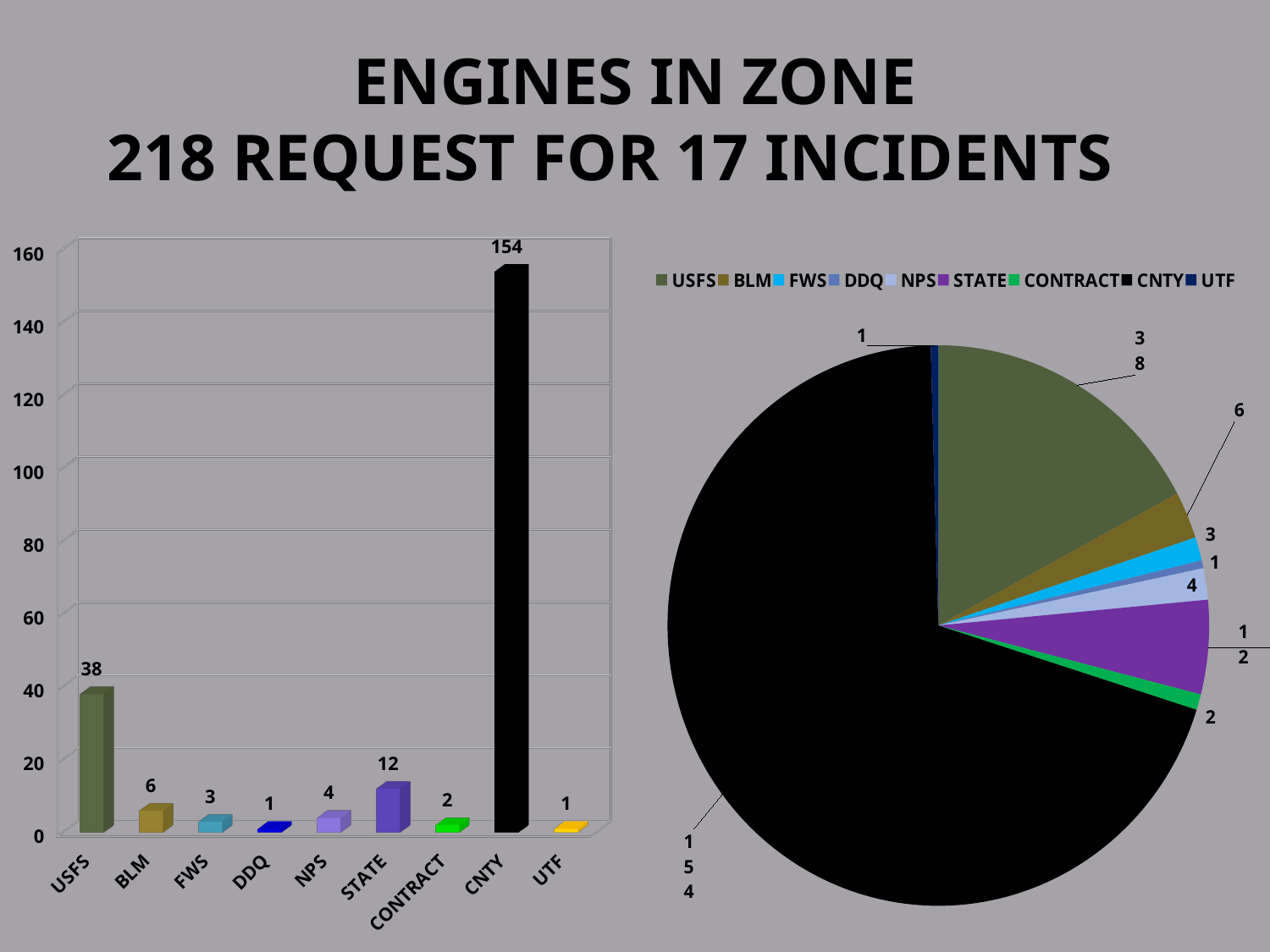
In the bar chart on the left, what is the value for CNTY? 154 In the bar chart on the left, what is the value for USFS? 38 In the pie chart on the right, how many entries does the legend list? 9 What is the title of the slide? ENGINES IN ZONE 218 REQUEST FOR 17 INCIDENTS In the bar chart on the left, which category has the highest value? CNTY What kind of chart is on the right side of the slide? Pie chart In the bar chart on the left, which is larger, the value for BLM or the value for NPS? BLM What kind of chart is on the left side of the slide? Bar chart In the bar chart on the left, how many categories are shown on the x axis? 9 In the bar chart on the left, what is the value for STATE? 12 In the bar chart on the left, is the value for CNTY greater or less than 140? greater In the bar chart on the left, what is the difference between the values for CNTY and USFS? 116